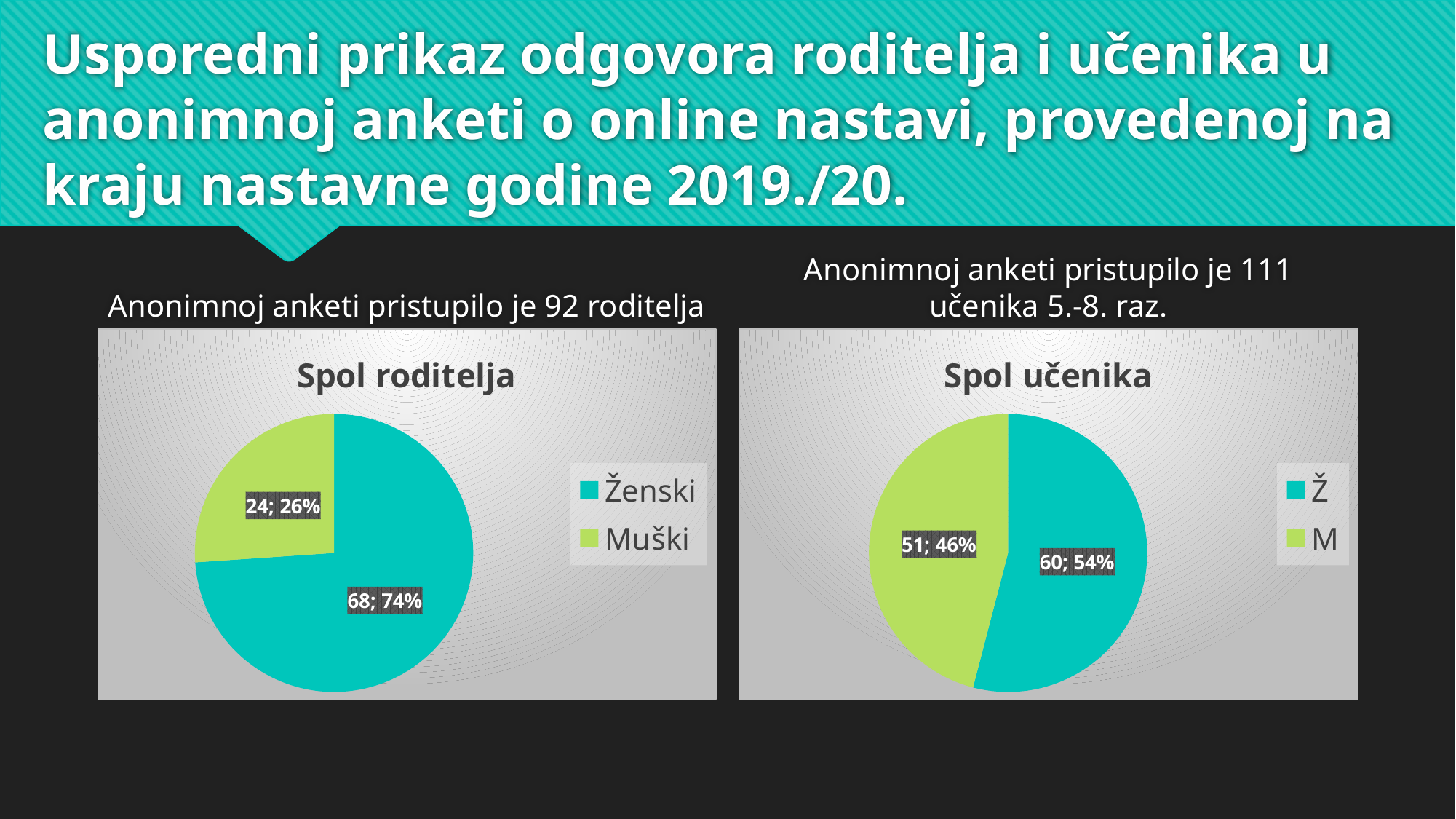
In the "Spol roditelja" chart, which category has the largest slice? Ženski In the "Spol roditelja" chart, what is the count for Ženski? 68 In the "Spol učenika" chart, which is larger, Ž or M? Ž In the "Spol roditelja" chart, what percentage share does Muški have? 26% In the "Spol učenika" chart, what percentage share does Ž have? 54% In the "Spol učenika" chart, which category has the smallest slice? M In the "Spol roditelja" chart, what is the difference between the Ženski and Muški counts? 44 In the "Spol učenika" chart, what is the count for M? 51 In the "Spol roditelja" chart, what colour is the Muški slice? Green What type of chart is "Spol roditelja"? Pie chart In the "Spol učenika" chart, what is the difference between the Ž and M counts? 9 How many categories does the "Spol učenika" chart show? 2